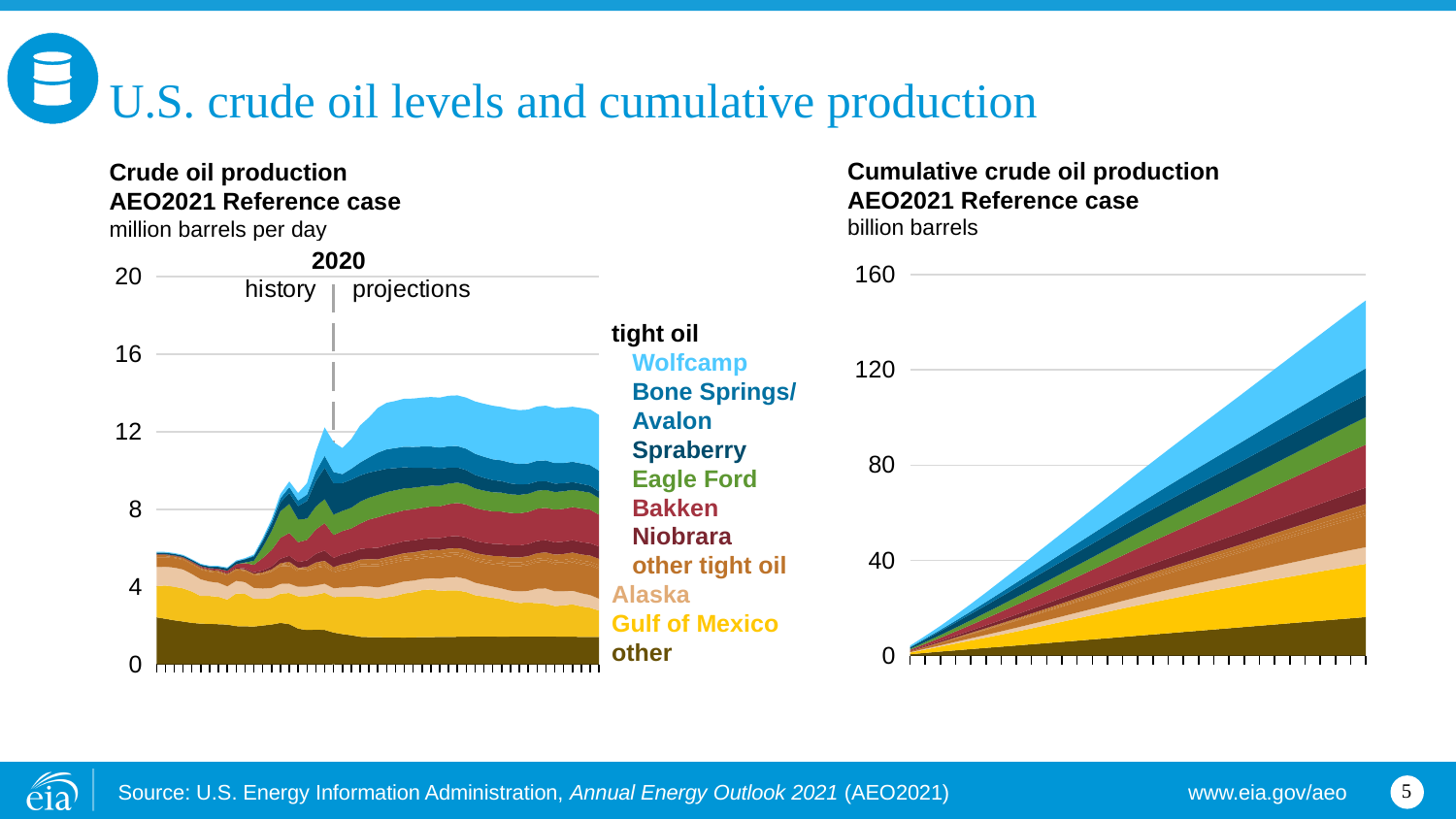
In the 'Crude oil production' chart, is the total production at the start of the history period greater or less than 8? less What kind of chart is the 'Cumulative crude oil production' chart on the right? stacked area chart In the 'Crude oil production' chart, how many series does the legend list (excluding the 'tight oil' group heading)? 10 In the 'Cumulative crude oil production' chart, is the total value at the right end of the chart greater or less than 120? greater What kind of chart is the 'Crude oil production' chart on the left? stacked area chart In the 'Crude oil production' chart, what unit is shown under the title? million barrels per day In the 'Crude oil production' chart, which series is plotted at the bottom of the stack? other In the 'Crude oil production' chart, does total production rise or fall over the history period up to 2020? rise In the 'Cumulative crude oil production' chart, do the total values rise or fall along the x axis? rise In the 'Crude oil production' chart, is the total production at the right end of the projection period greater or less than 12? greater In the 'Crude oil production' chart, what year does the dashed line separating history from projections mark? 2020